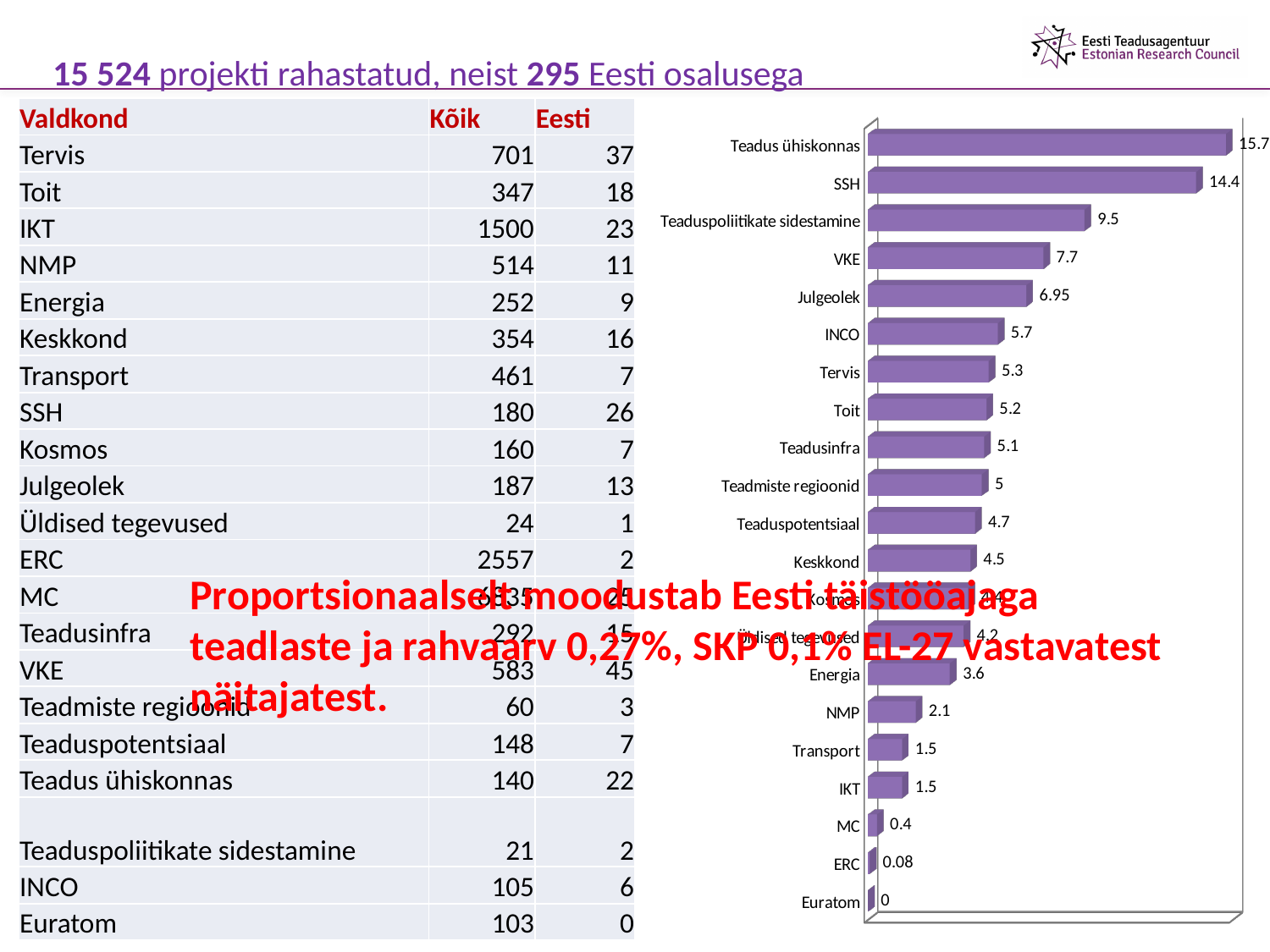
What kind of chart is shown on the right side of the slide? Bar chart What is the difference between the values for Teadus ühiskonnas and SSH in the bar chart? 1.3 How many categories are shown in the bar chart? 21 What is the value for SSH in the bar chart? 14.4 What is the value for Teadus ühiskonnas in the bar chart? 15.7 What is the value for ERC in the bar chart? 0.08 Which category has the highest value in the bar chart? Teadus ühiskonnas What is the value for Julgeolek in the bar chart? 6.95 What is the difference between the values for VKE and Energia in the bar chart? 4.1 In the bar chart, which is larger: the value for Teaduspoliitikate sidestamine or the value for INCO? Teaduspoliitikate sidestamine Do the values in the bar chart rise or fall going from the top bar to the bottom bar? Fall Which category has the lowest value in the bar chart? Euratom